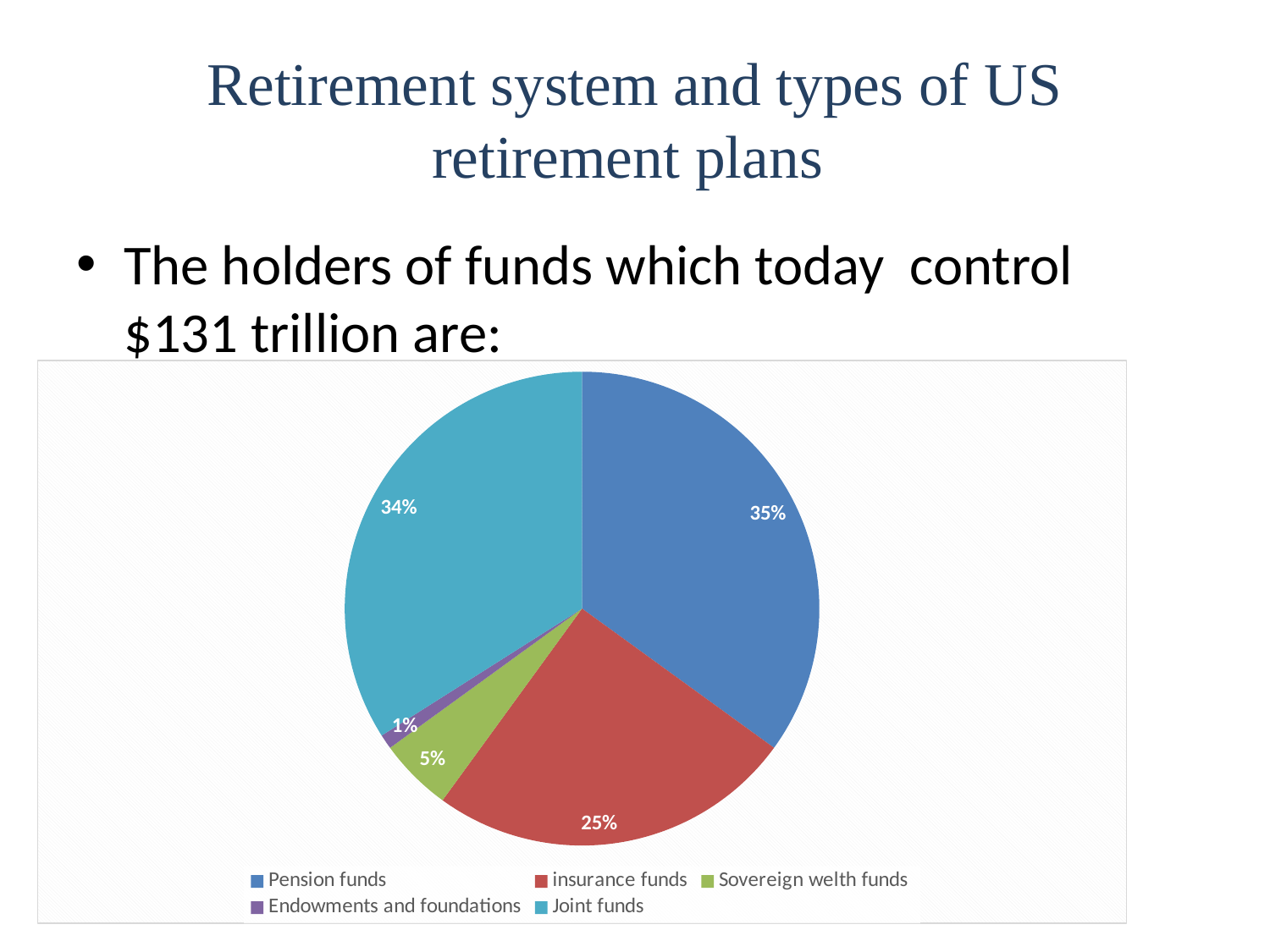
What kind of chart is shown on the slide? pie chart What share of the pie is insurance funds? 25% What share of the pie is Endowments and foundations? 1% What colour is the Joint funds slice? teal Which category has the smallest slice of the pie? Endowments and foundations What is the difference in percentage points between the Pension funds slice and the insurance funds slice? 10 Which category has the largest slice of the pie? Pension funds Which is larger, the slice for insurance funds or the slice for Sovereign welth funds? insurance funds What share of the pie is Pension funds? 35% What share of the pie is Sovereign welth funds? 5% How many categories does the pie chart have? 5 What share of the pie is Joint funds? 34%